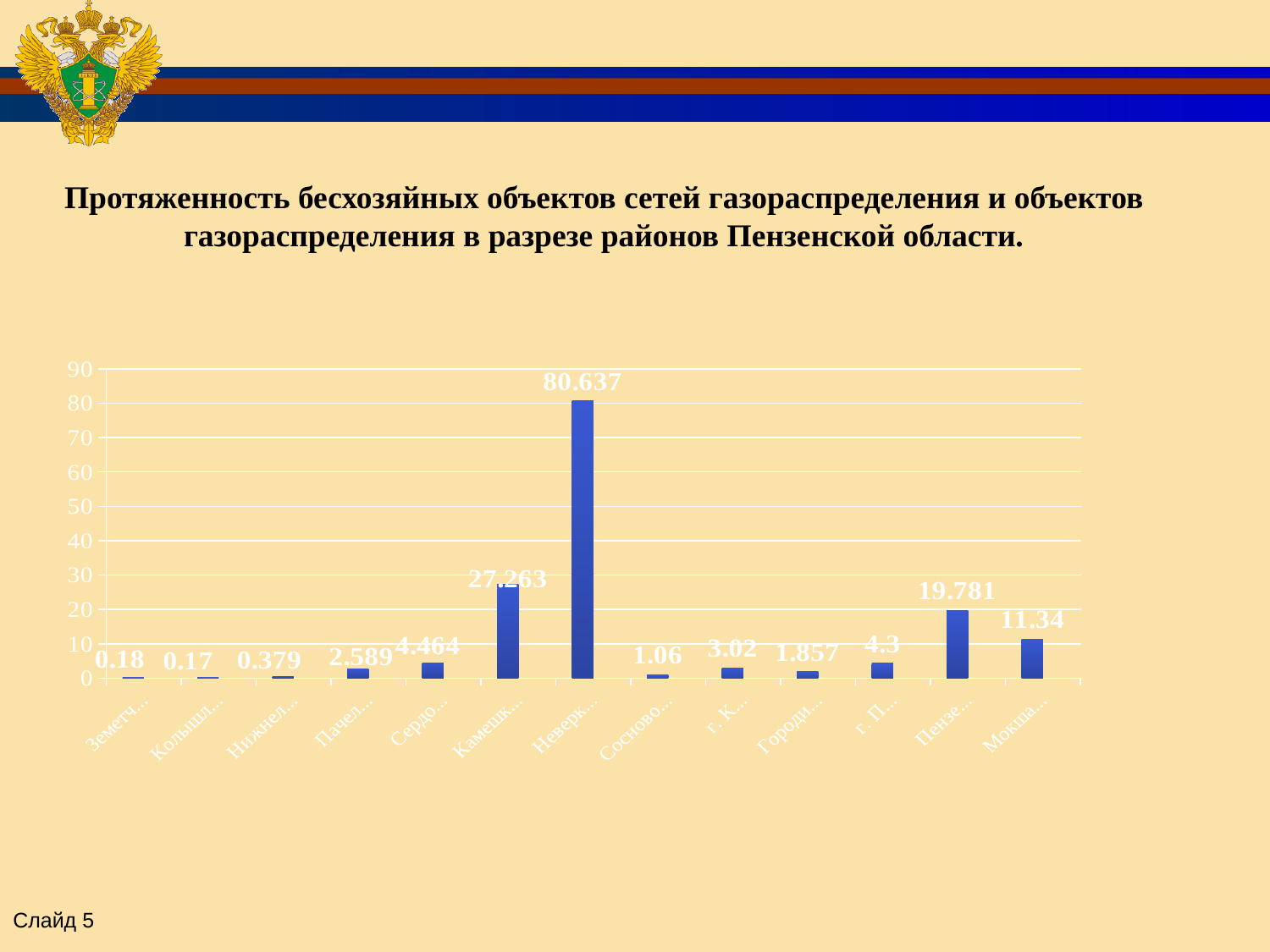
What is the value of the first bar (Земетч...)? 0.18 What is the value of the tallest bar in the chart? 80.637 What type of chart is shown on the slide? bar chart Is the value of the seventh bar (Неверк...) greater or less than 70? greater What is the value of the twelfth bar (Пензе...)? 19.781 What is the value of the last bar (Мокша...)? 11.34 Which bar has the highest value in the chart? the seventh bar (Неверк...) What is the highest value shown on the vertical axis? 90 What is the difference between the tallest bar (80.637) and the sixth bar (27.263)? 53.374 What is the value of the sixth bar (Камешк...)? 27.263 Which is larger: the value of the twelfth bar (Пензе...) or the last bar (Мокша...)? the twelfth bar (Пензе...), 19.781 How many bars (categories) are plotted in the chart? 13